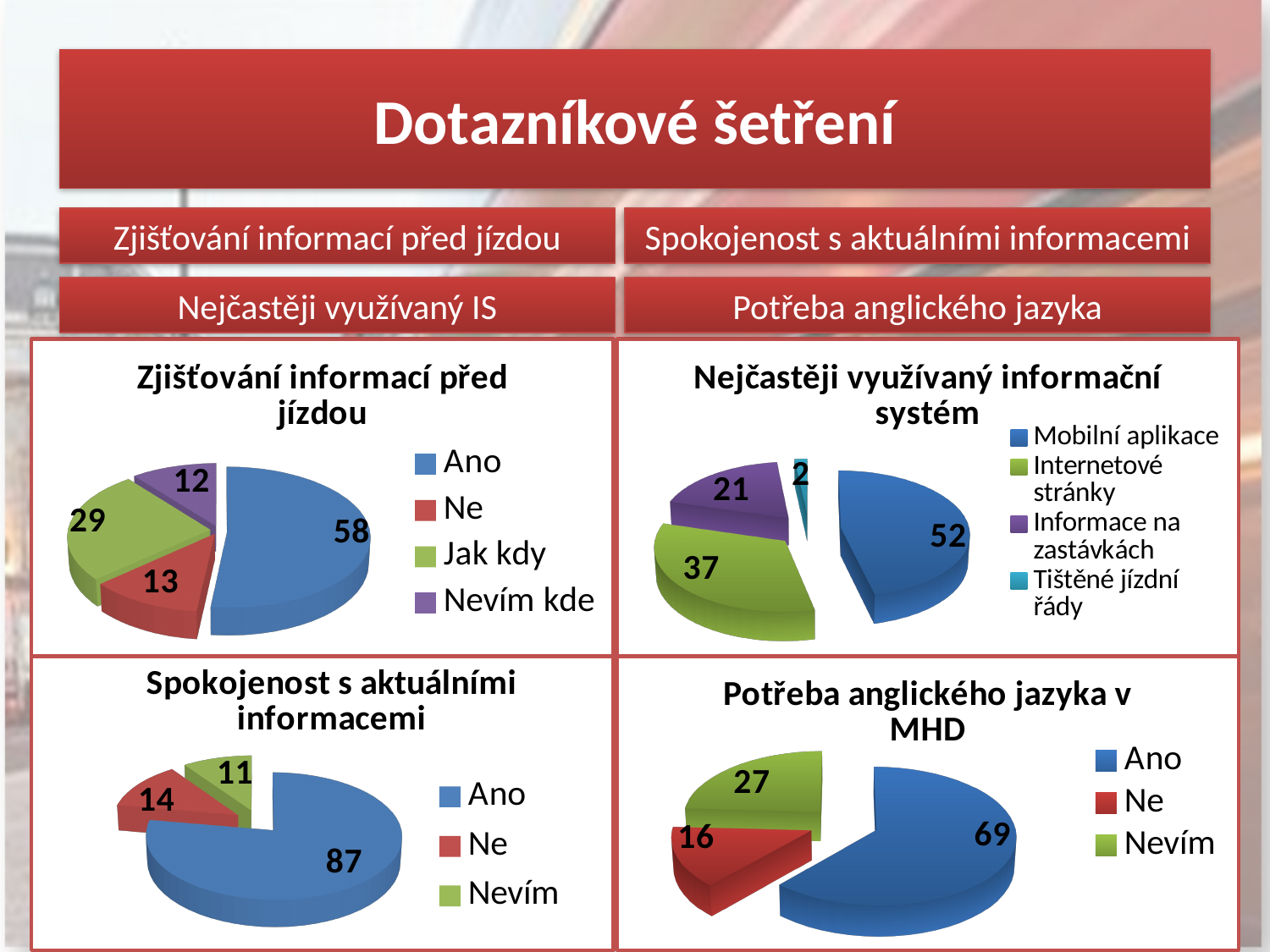
In the chart titled "Spokojenost s aktuálními informacemi", which is larger, "Ne" or "Nevím"? Ne How many charts are shown on the slide? 4 In the chart titled "Nejčastěji využívaný informační systém", which category has the highest value? Mobilní aplikace In the chart titled "Zjišťování informací před jízdou", what is the value for "Ano"? 58 In the chart titled "Zjišťování informací před jízdou", what is the difference between the values for "Jak kdy" and "Ne"? 16 In the chart titled "Potřeba anglického jazyka v MHD", what is the difference between the values for "Ano" and "Ne"? 53 In the chart titled "Nejčastěji využívaný informační systém", what is the value for "Internetové stránky"? 37 How many categories does the legend of the chart titled "Nejčastěji využívaný informační systém" list? 4 In the chart titled "Zjišťování informací před jízdou", which category has the lowest value? Nevím kde What kind of chart is the chart titled "Potřeba anglického jazyka v MHD"? Pie chart In the chart titled "Spokojenost s aktuálními informacemi", what is the value for "Ne"? 14 In the chart titled "Potřeba anglického jazyka v MHD", what is the value for "Nevím"? 27